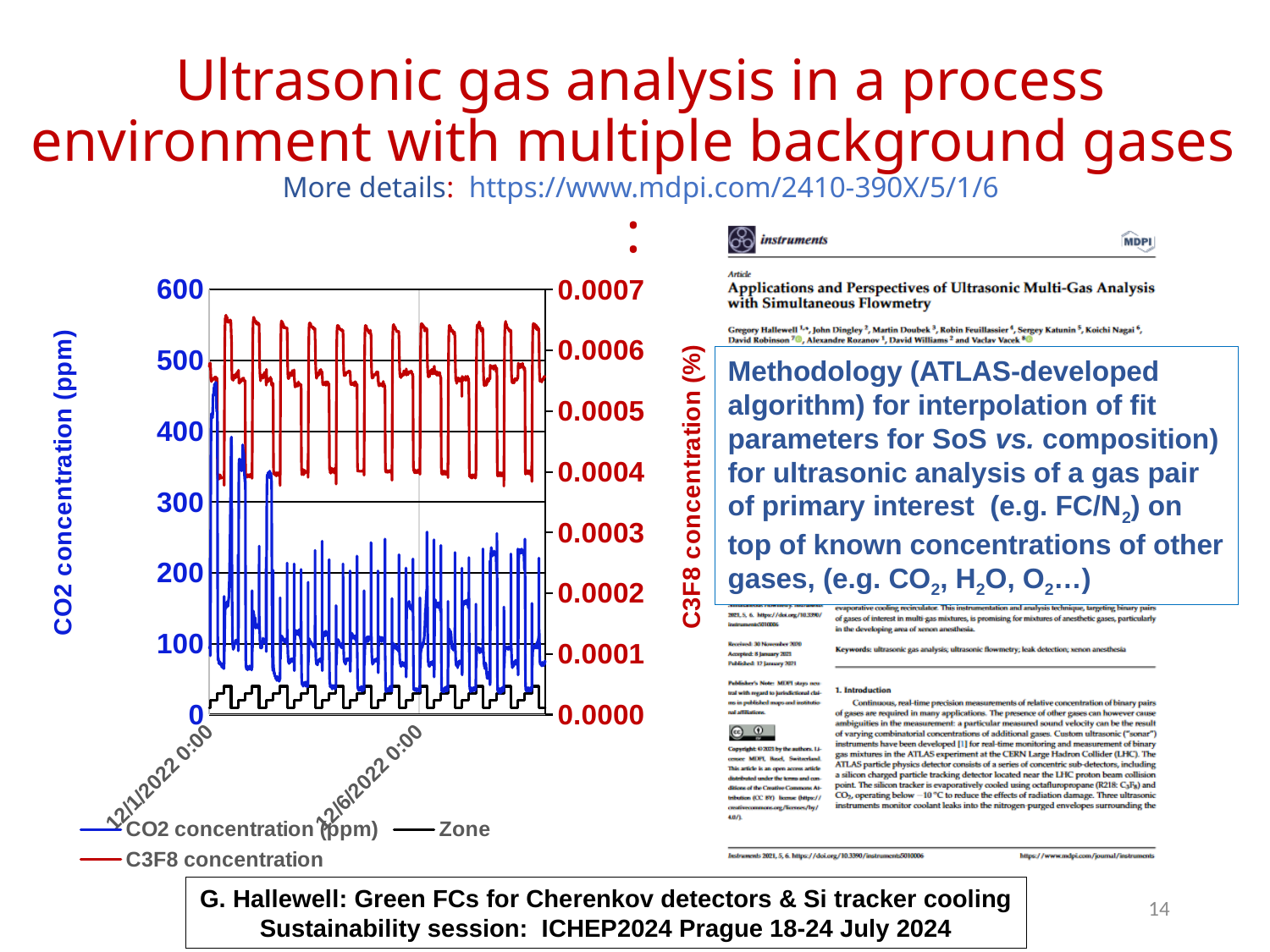
What is the maximum value shown on the left vertical axis (CO2 concentration) of the chart? 600 What is the first date label shown on the x axis of the chart? 12/1/2022 0:00 Which series in the chart is drawn in red? C3F8 concentration Is the Zone series in the chart plotted above or below the 100 mark on the left axis? below Are the lower plateaus of the C3F8 concentration series greater or less than 0.0005 on the right axis? less How many series does the legend of the chart list? 3 Is the highest CO2 concentration value reached in the chart greater or less than 400 ppm? greater What kind of chart is shown on the left of the slide? line chart What is the title of the left vertical axis of the chart? CO2 concentration (ppm) What is the maximum value shown on the right vertical axis (C3F8 concentration) of the chart? 0.0007 Which series in the chart is drawn in blue? CO2 concentration (ppm)